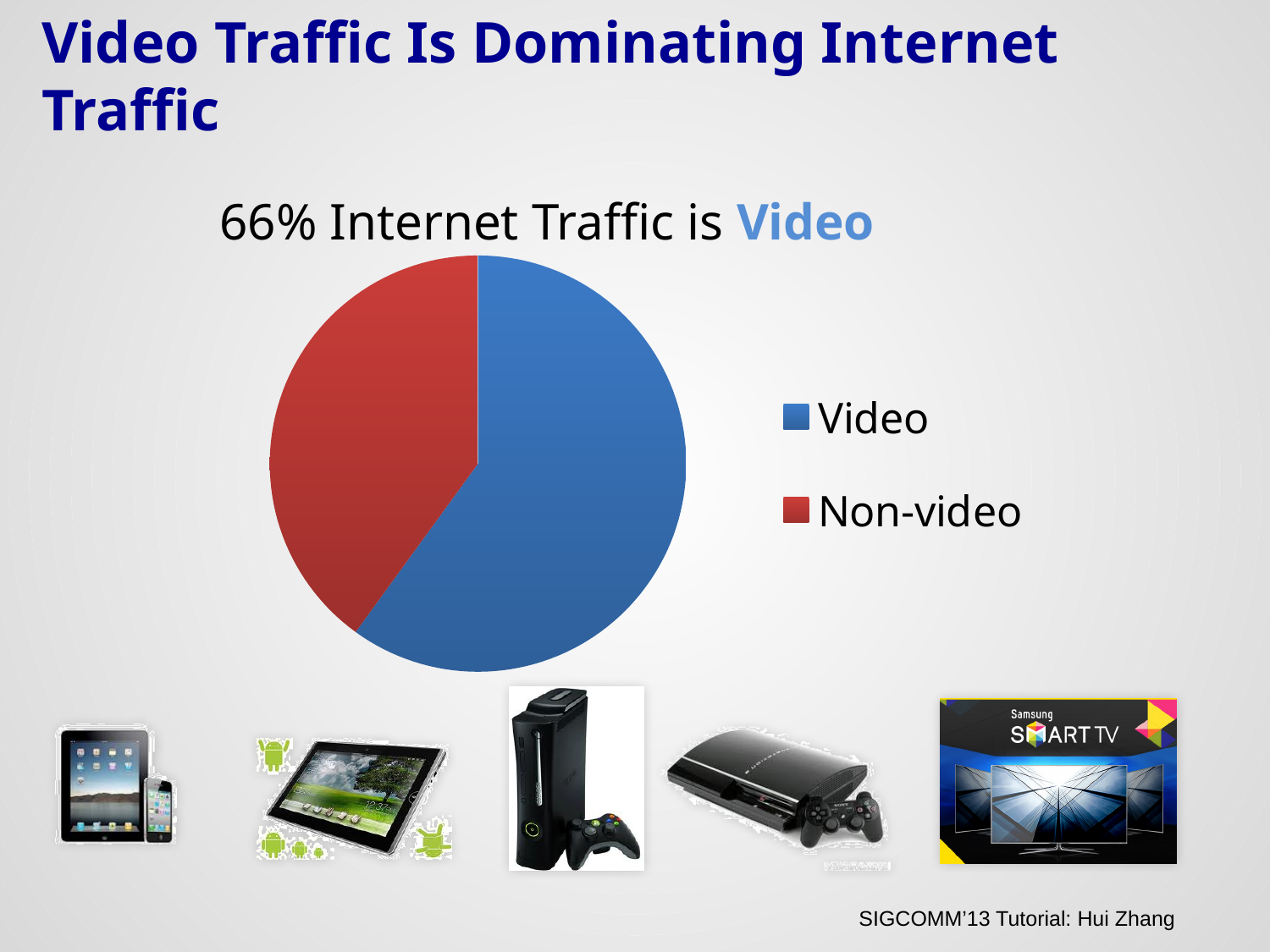
Which is larger in the pie chart, Video or Non-video? Video What are the two legend entries of the pie chart? Video and Non-video What kind of chart is shown on the slide? pie chart How many entries does the legend of the pie chart list? 2 Which slice of the pie chart is the smallest? Non-video What colour is the Video slice in the pie chart? blue What share of Internet traffic does the Video slice represent, according to the slide? 66% Which slice of the pie chart is the largest? Video How many slices does the pie chart have? 2